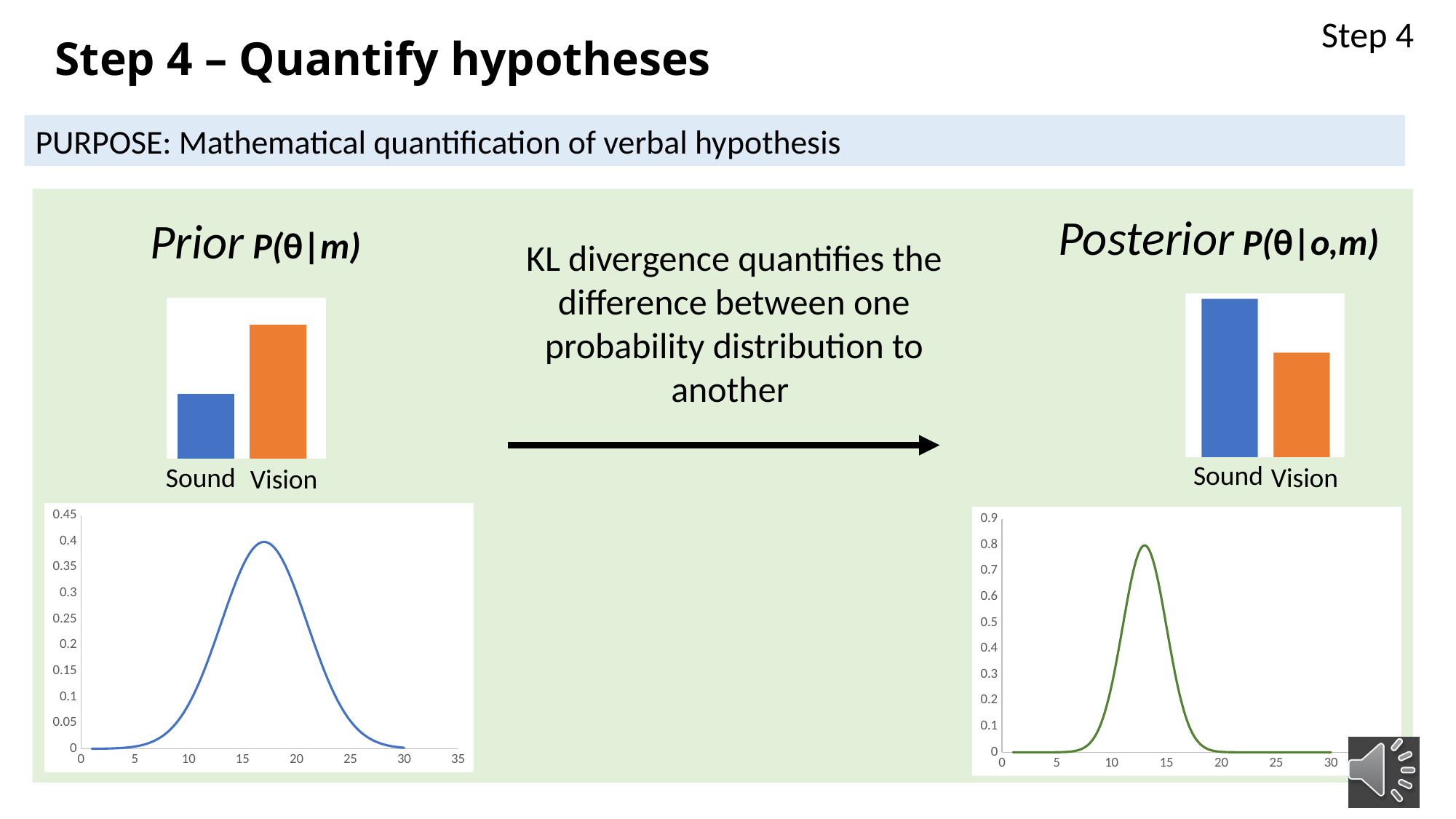
What is the highest value shown on the y axis of the bottom-right line chart? 0.9 In the bottom-left line chart, is the peak value of the curve greater or less than 0.35? greater In the Posterior bar chart, which category has the taller bar, Sound or Vision? Sound What colour is the curve in the bottom-left line chart? blue In the Posterior bar chart, which category is the lowest? Vision How many categories are shown in the Prior bar chart? 2 What kind of chart is the Prior chart with the Sound and Vision bars? bar chart In the bottom-left line chart, does the curve rise or fall between x = 20 and x = 30? fall In the bottom-right line chart, does the curve rise or fall between x = 5 and x = 13? rise In the Prior bar chart, which category has the taller bar, Sound or Vision? Vision In the bottom-right line chart, is the peak value of the curve greater or less than 0.7? greater What kind of chart is the bottom-left chart under the Prior heading? line chart